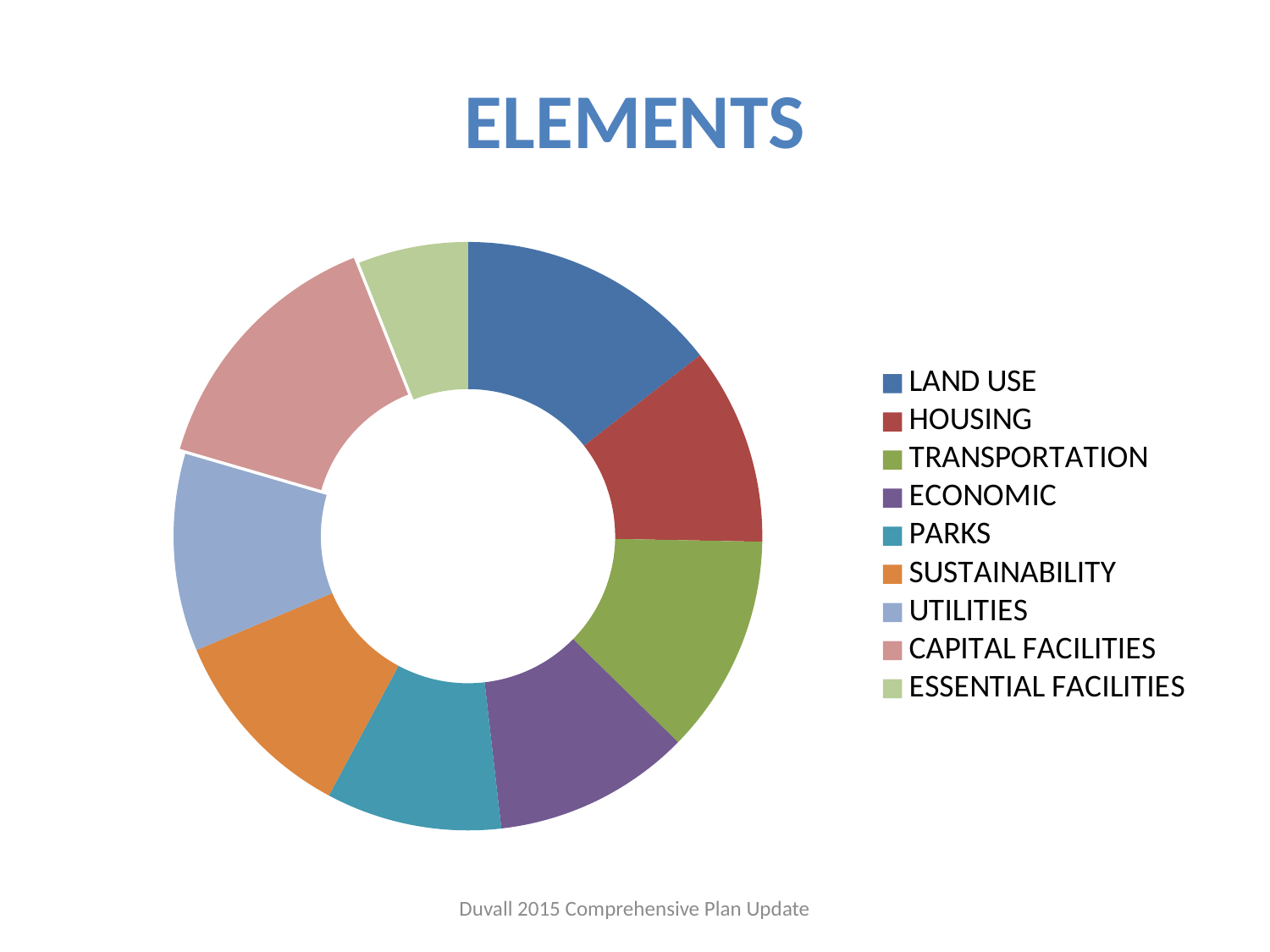
Which slice is larger, HOUSING or ESSENTIAL FACILITIES? HOUSING What kind of chart is shown on the slide? Doughnut chart Which slice is larger, LAND USE or ESSENTIAL FACILITIES? LAND USE Which category has the smallest slice in the doughnut chart? ESSENTIAL FACILITIES Which category is shown in orange in the doughnut chart? SUSTAINABILITY What is the title of the chart on the slide? ELEMENTS How many categories does the doughnut chart show? 9 Which slice is larger, CAPITAL FACILITIES or PARKS? CAPITAL FACILITIES